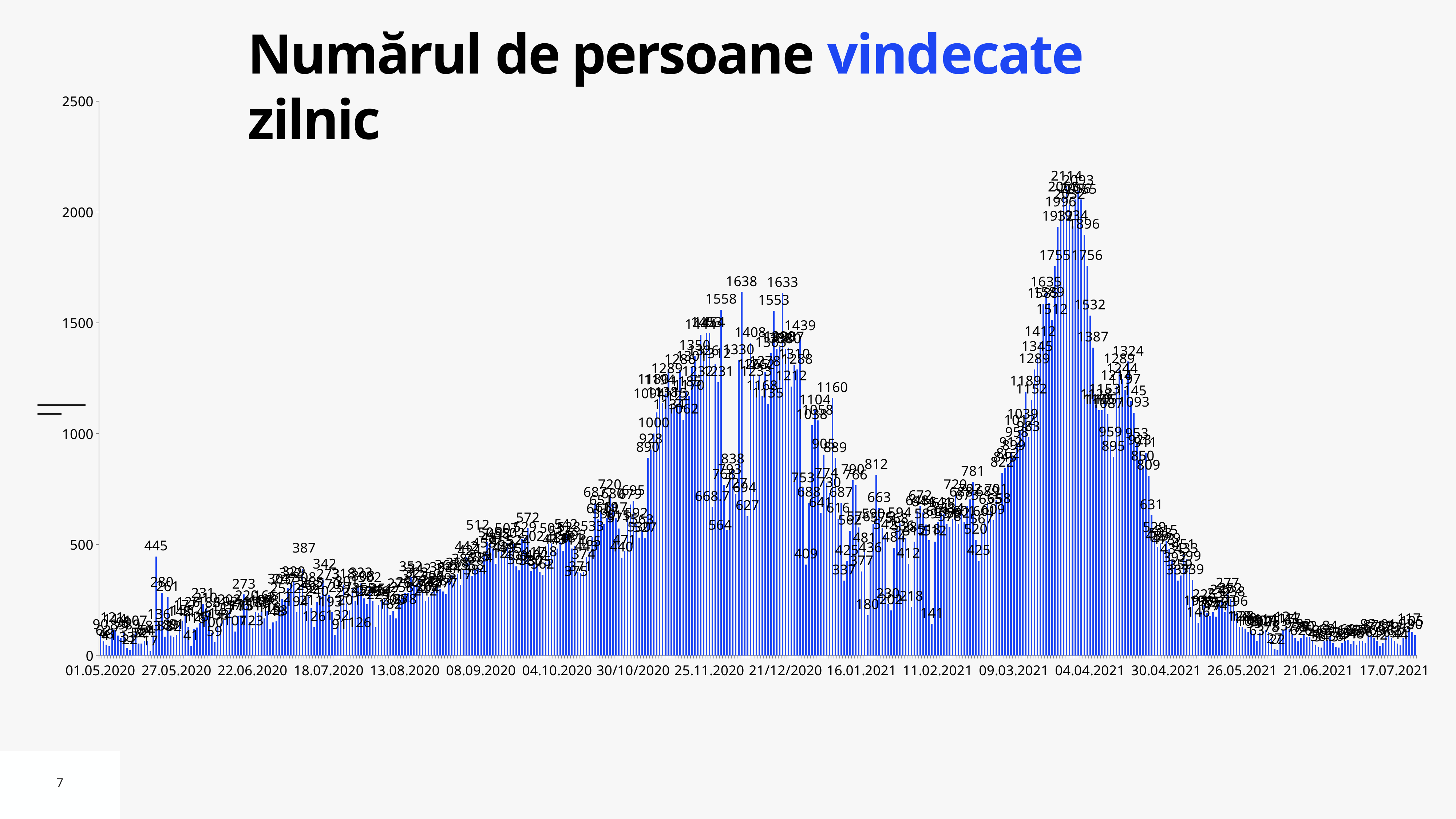
Which is larger, the labelled value 445 near 27.05.2020 or the labelled value 387 near 18.07.2020? 445 Which is larger, the labelled value 1638 or the labelled value 1633 in the December 2020 peak? 1638 What is the difference between the peak value 2114 and the labelled value 1638? 476 What is the highest value labelled on the chart? 2114 Is the value of the tallest bar near 04.04.2021 greater or less than 2000? greater Is the value for the first bar at 01.05.2020 greater or less than 500? less What is the title of the chart on the slide? Numărul de persoane vindecate zilnic What is the highest value shown on the vertical axis? 2500 What is the difference between the labelled values 445 and 387? 58 What kind of chart is shown on the slide? bar chart Do the values rise or fall between 04.04.2021 and 30.04.2021? fall How many date labels are shown along the x axis? 18